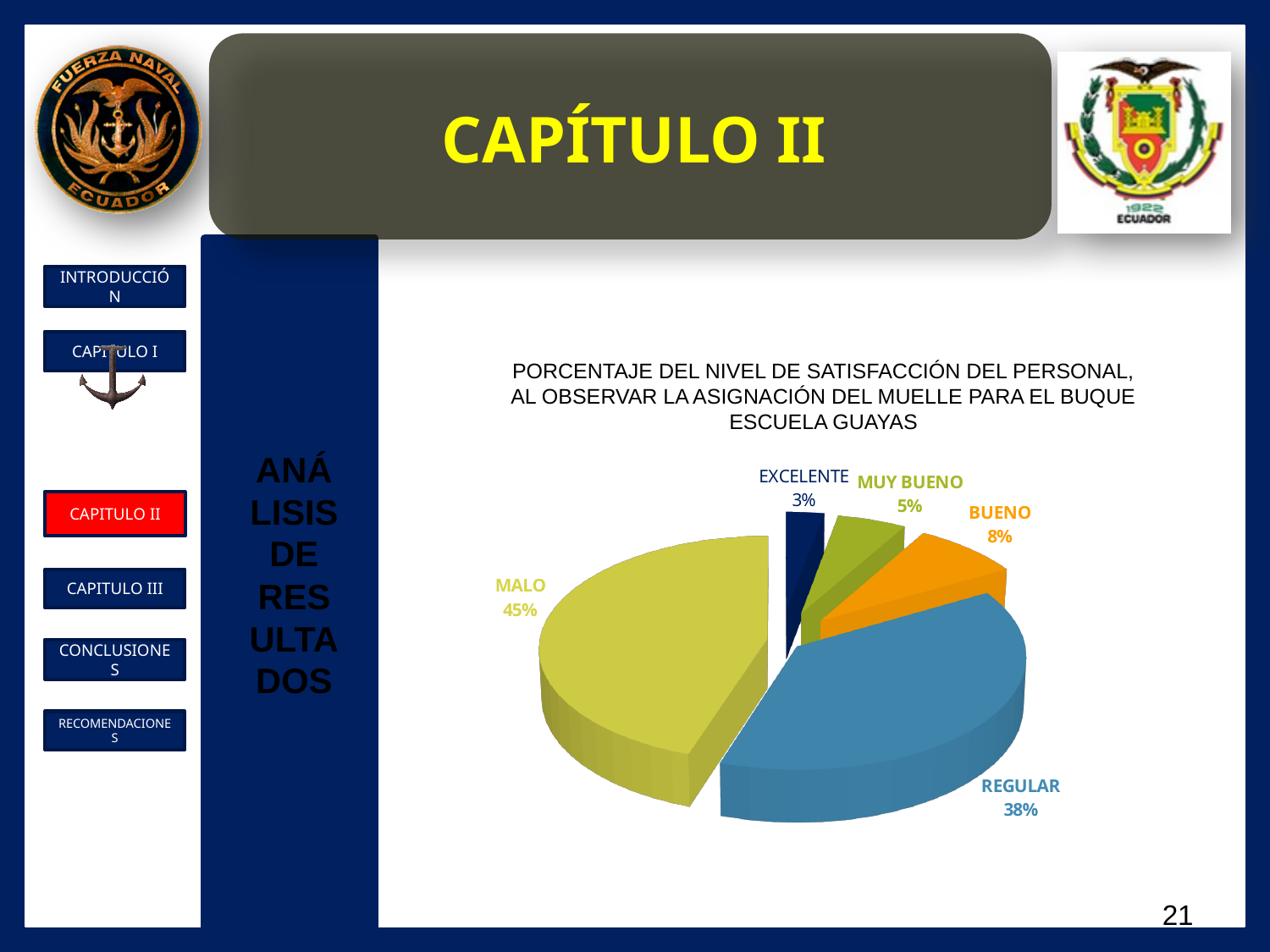
What is the difference in percentage points between MALO and REGULAR? 7 What percentage is shown for MUY BUENO? 5% What kind of chart is shown on the slide? Pie chart What percentage is shown for MALO? 45% What percentage is shown for EXCELENTE? 3% Which category has the smallest share of the pie? EXCELENTE What is the combined share of MALO and REGULAR? 83% How many categories are shown in the pie chart? 5 What percentage is shown for REGULAR? 38% Which category has the largest share of the pie? MALO Which is larger, the share for BUENO or the share for MUY BUENO? BUENO What percentage is shown for BUENO? 8%